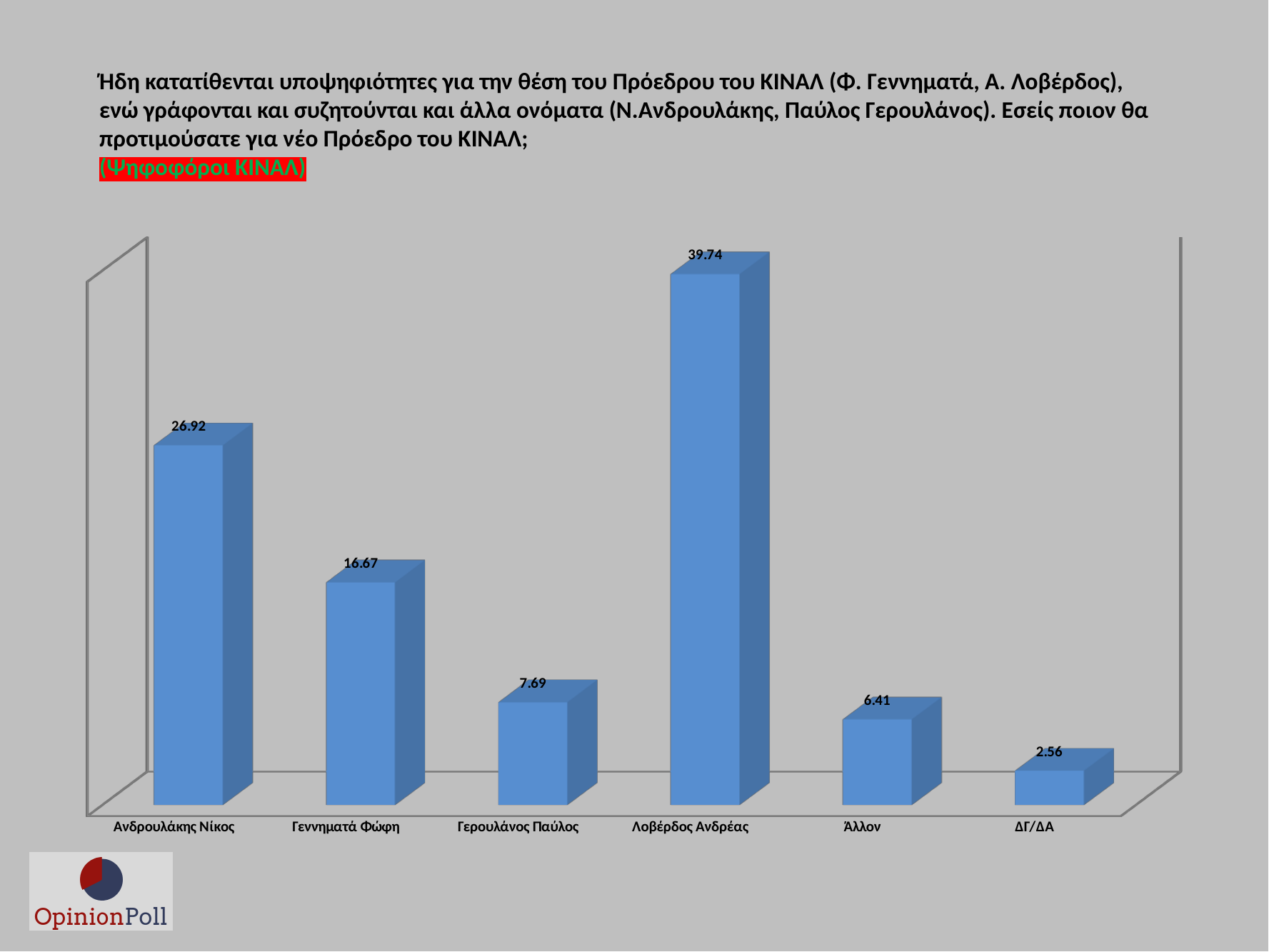
What is the difference between the values for Λοβέρδος Ανδρέας and Ανδρουλάκης Νίκος? 12.82 What colour are the bars in the chart? Blue What is the value shown for ΔΓ/ΔΑ? 2.56 What kind of chart is shown on the slide? Bar chart How many categories are shown on the chart? 6 What is the value shown for Ανδρουλάκης Νίκος? 26.92 Which category has the highest value? Λοβέρδος Ανδρέας What is the value shown for Λοβέρδος Ανδρέας? 39.74 What is the value shown for Γεννηματά Φώφη? 16.67 What is the difference between the values for Ανδρουλάκης Νίκος and Γεννηματά Φώφη? 10.25 Which is larger, the value for Γερουλάνος Παύλος or the value for Άλλον? Γερουλάνος Παύλος Which category has the lowest value? ΔΓ/ΔΑ